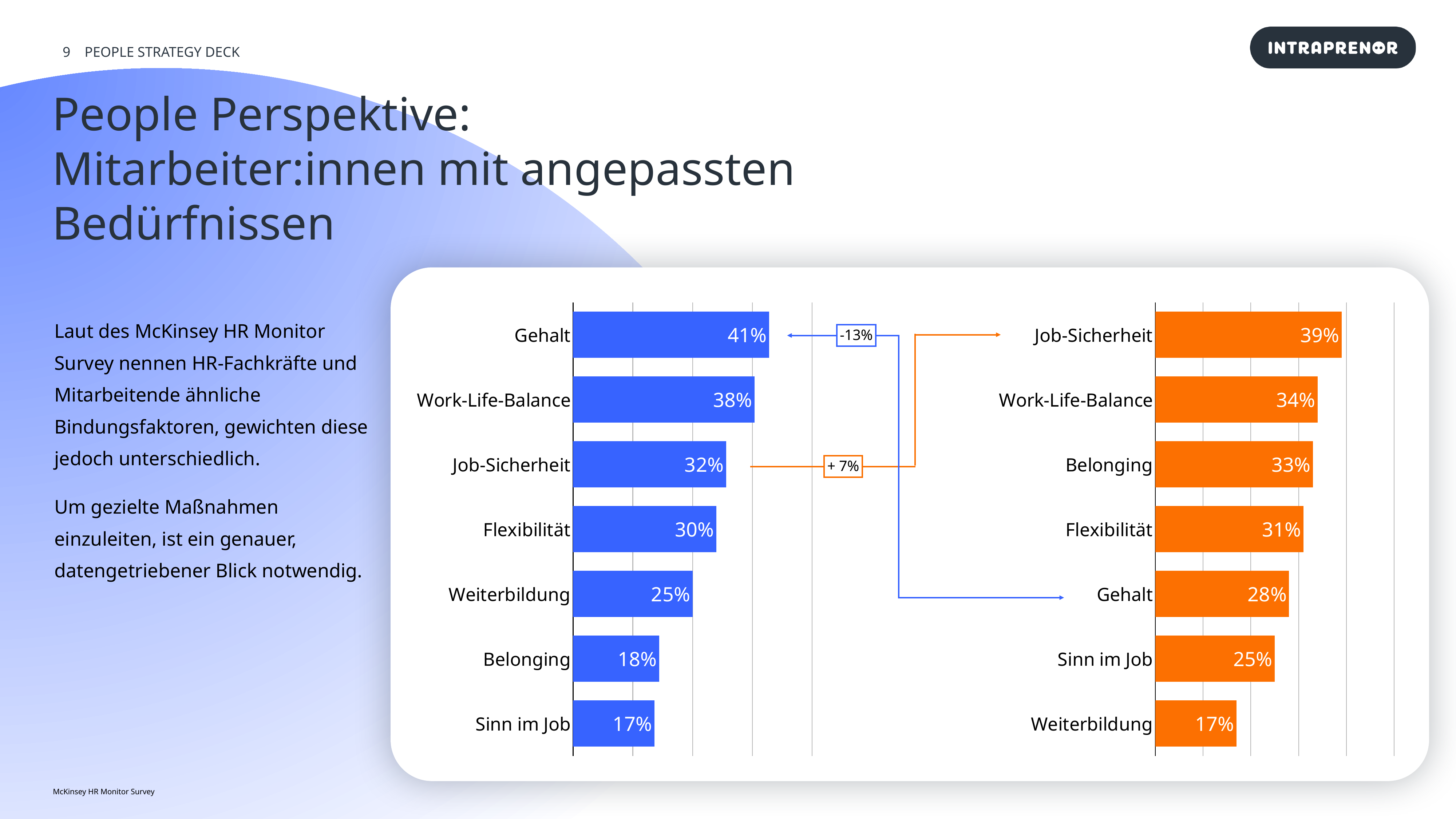
In the right (orange) bar chart, which category has the highest value? Job-Sicherheit In the right (orange) bar chart, what is the value for Belonging? 33% In the right (orange) bar chart, which category has the lowest value? Weiterbildung In the left (blue) bar chart, which category has the lowest value? Sinn im Job In the right (orange) bar chart, what is the value for Sinn im Job? 25% What type of chart is the right (orange) chart? Bar chart What is the difference between the value for Gehalt in the left (blue) chart and the value for Gehalt in the right (orange) chart? 13% Which is larger: Job-Sicherheit in the left (blue) chart or Job-Sicherheit in the right (orange) chart? Job-Sicherheit in the right (orange) chart In the left (blue) bar chart, what is the value for Gehalt? 41% In the left (blue) bar chart, what is the difference between Work-Life-Balance and Weiterbildung? 13% How many categories does the left (blue) bar chart show? 7 In the left (blue) bar chart, which is larger: Flexibilität or Belonging? Flexibilität